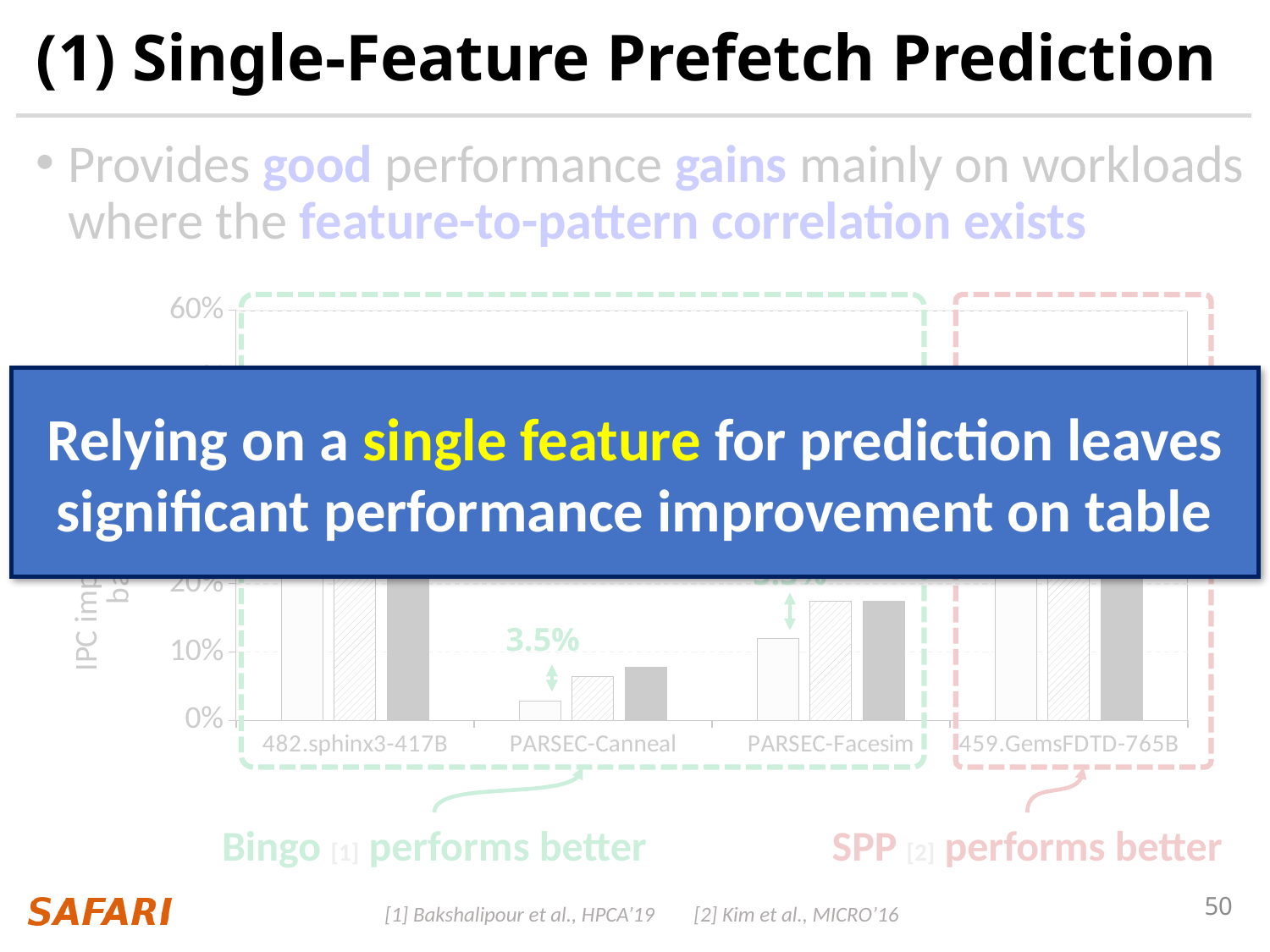
Are the bars for PARSEC-Canneal greater or less than 10%? less What percentage value is annotated above the PARSEC-Canneal bars? 3.5% What kind of chart is shown on the slide? bar chart Which category on the chart has the lowest bars? PARSEC-Canneal Is the first (white) bar for PARSEC-Facesim greater or less than 10%? greater Which category is enclosed in the red dashed box labelled 'SPP performs better'? 459.GemsFDTD-765B Which category has higher bars, PARSEC-Facesim or PARSEC-Canneal? PARSEC-Facesim Is the gray bar for PARSEC-Facesim greater or less than 20%? less How many categories are shown on the x axis of the chart? 4